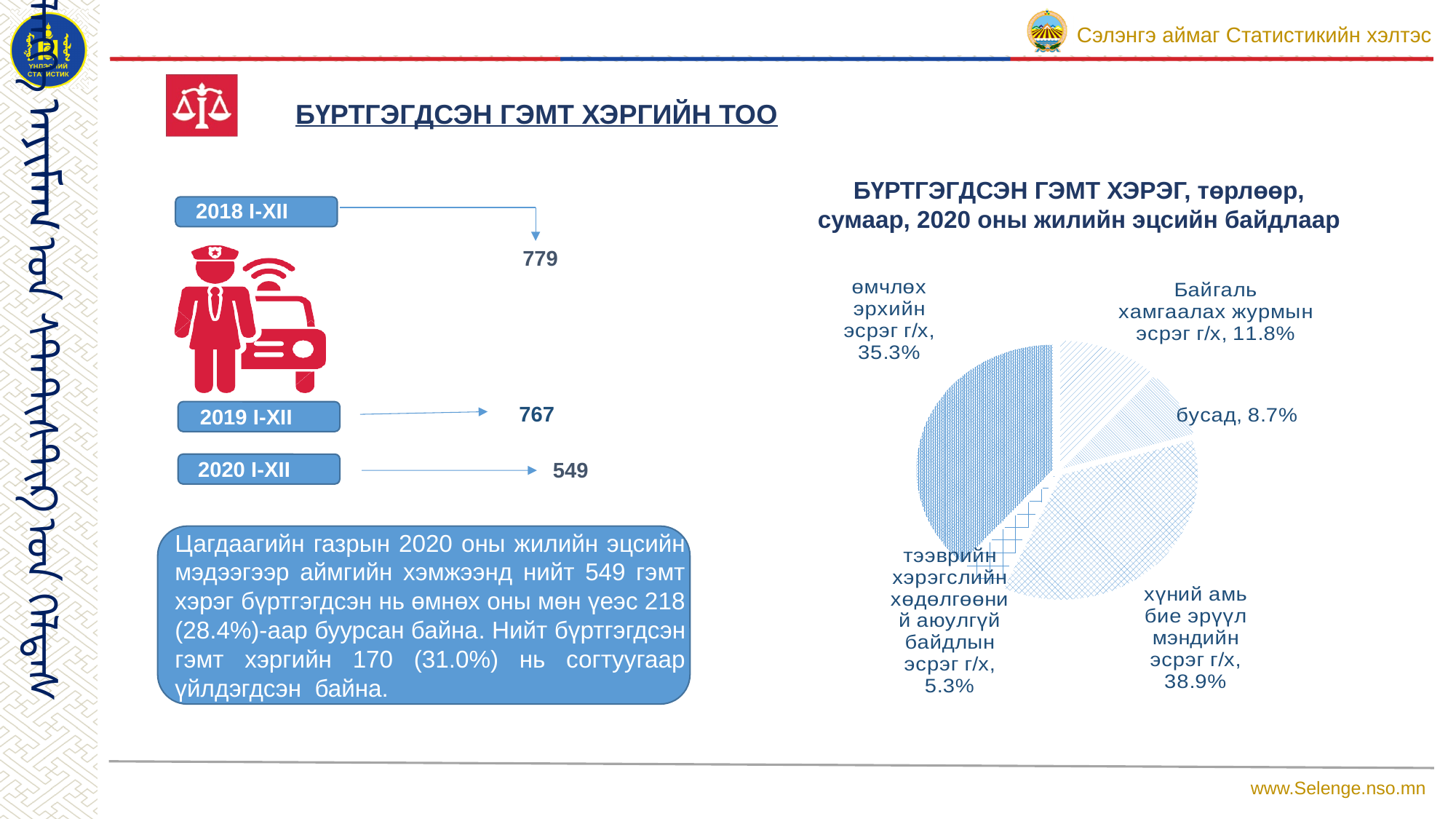
In the pie chart, which category has the largest share? хүний амь бие эрүүл мэндийн эсрэг г/х In the pie chart, which is larger: 'Байгаль хамгаалах журмын эсрэг г/х' or 'бусад'? Байгаль хамгаалах журмын эсрэг г/х In the pie chart, what share is labelled for 'бусад'? 8.7% In the pie chart, what share is labelled for 'тээврийн хэрэгслийн хөдөлгөөний аюулгүй байдлын эсрэг г/х'? 5.3% In the pie chart, what is the difference in percentage points between 'хүний амь бие эрүүл мэндийн эсрэг г/х' and 'өмчлөх эрхийн эсрэг г/х'? 3.6 What type of chart is shown on the right side of the slide? pie chart In the pie chart, what share is labelled for 'Байгаль хамгаалах журмын эсрэг г/х'? 11.8% In the pie chart, what share is labelled for 'хүний амь бие эрүүл мэндийн эсрэг г/х'? 38.9% How many slices does the pie chart have? 5 In the pie chart, what share is labelled for 'өмчлөх эрхийн эсрэг г/х'? 35.3% What is the title of the pie chart on the right? БҮРТГЭГДСЭН ГЭМТ ХЭРЭГ, төрлөөр, сумаар, 2020 оны жилийн эцсийн байдлаар In the pie chart, which category has the smallest share? тээврийн хэрэгслийн хөдөлгөөний аюулгүй байдлын эсрэг г/х